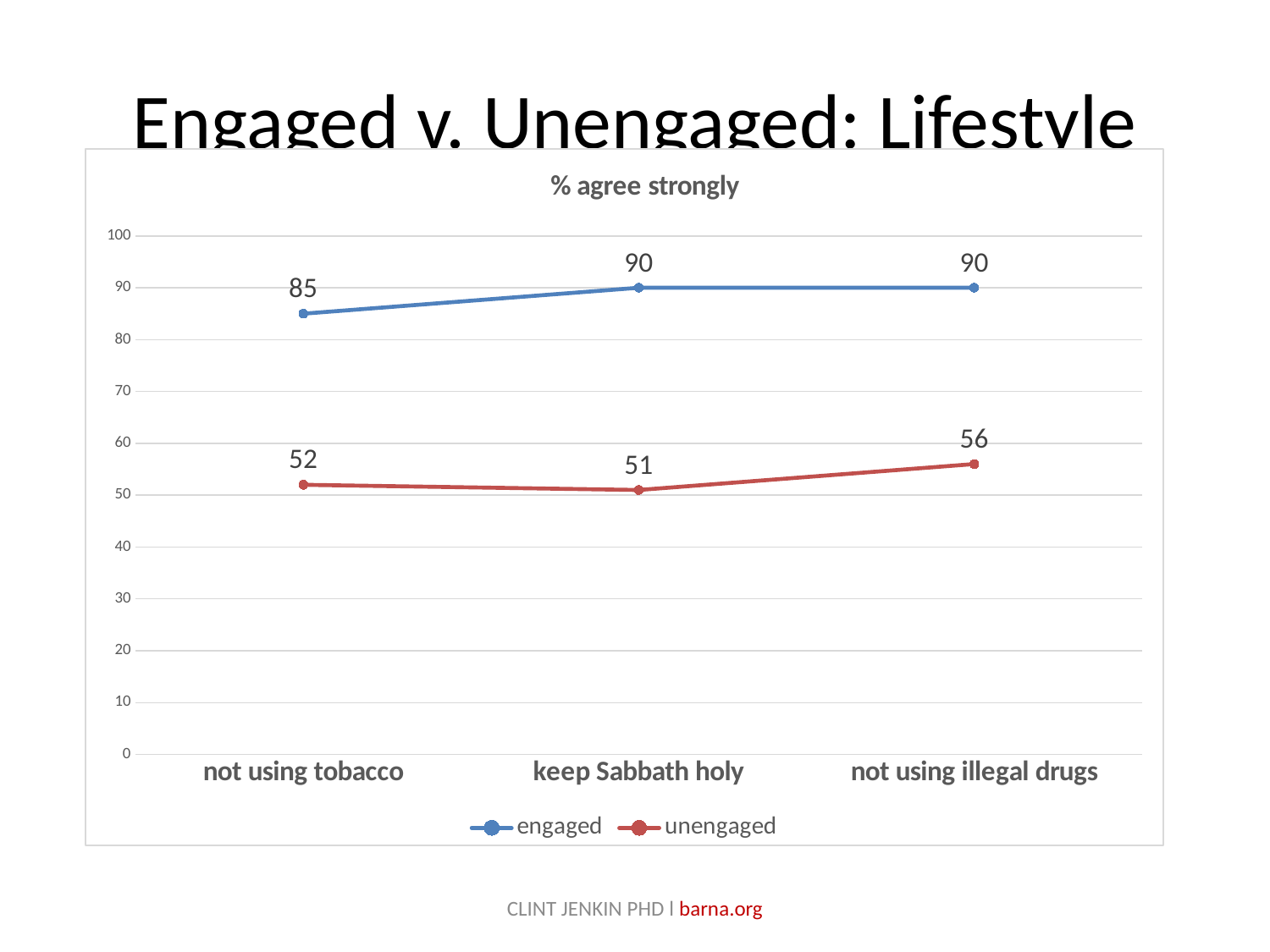
Which series has the larger value at "not using tobacco", engaged or unengaged? engaged Which category has the highest value for the unengaged series? not using illegal drugs What is the difference between the engaged and unengaged values at "keep Sabbath holy"? 39 What is the value for the unengaged series at "not using illegal drugs"? 56 What is the difference between the engaged values at "not using tobacco" and "keep Sabbath holy"? 5 What is the value for the engaged series at "not using tobacco"? 85 What is the title of the chart? % agree strongly What is the value for the unengaged series at "keep Sabbath holy"? 51 How many categories are shown on the x axis? 3 Which category has the lowest value for the unengaged series? keep Sabbath holy What kind of chart is shown on the slide? line chart How many series does the legend list? 2